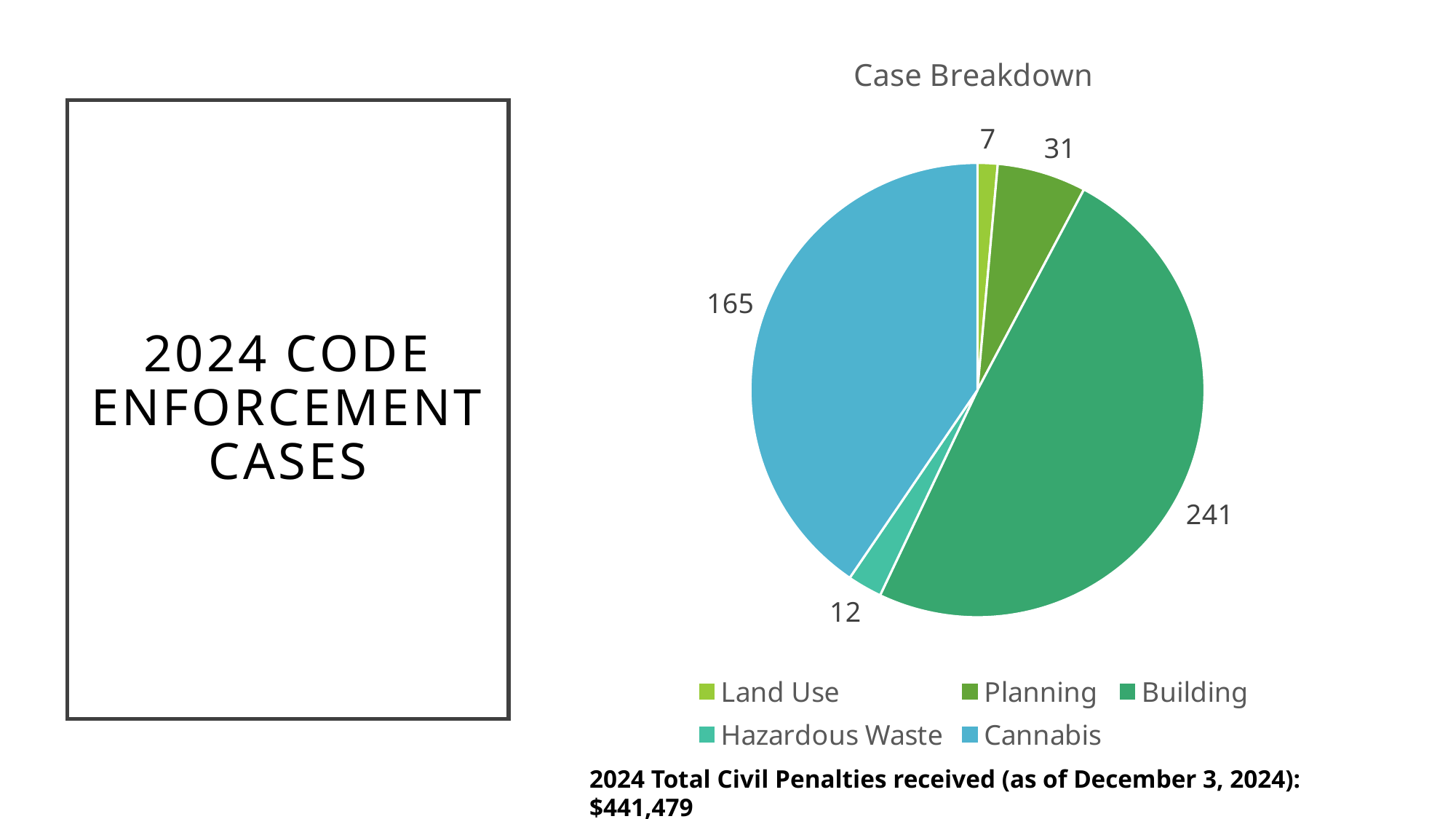
What is the total number of cases across all slices of the pie? 456 How many cases are shown for Hazardous Waste? 12 Which category has the smallest slice of the pie? Land Use How many cases are shown for Planning? 31 Which has more cases, Planning or Hazardous Waste? Planning What is the title of the chart? Case Breakdown What type of chart is shown on the slide? pie chart How many cases are shown for Cannabis? 165 Which category has the largest slice of the pie? Building What is the difference between the Building and Cannabis case counts? 76 How many categories does the pie chart show? 5 How many cases are shown for Building? 241